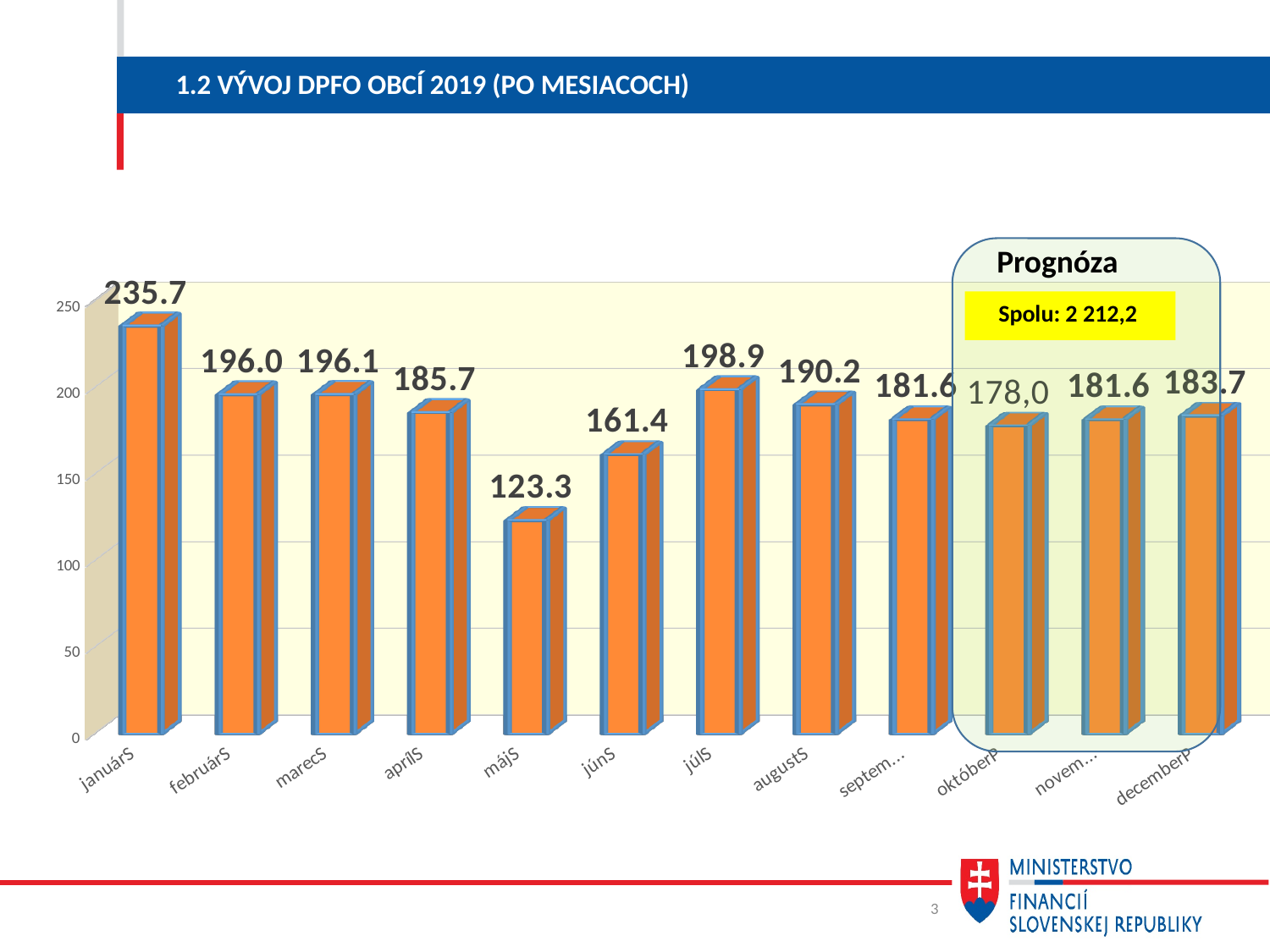
Which is larger, the value for júlS or the value for augustS? júlS Which month has the highest value? januárS What is the difference between the values for januárS and februárS? 39.7 What is the value for májS? 123.3 Do the values rise or fall from januárS to májS? fall What is the value for januárS? 235.7 What total is shown in the Prognóza box on the chart? Spolu: 2 212,2 Is the value for júnS greater or less than 150? greater What is the value for októberP? 178,0 How many months are plotted on the chart? 12 Which month has the lowest value? májS What kind of chart is shown on the slide? bar chart